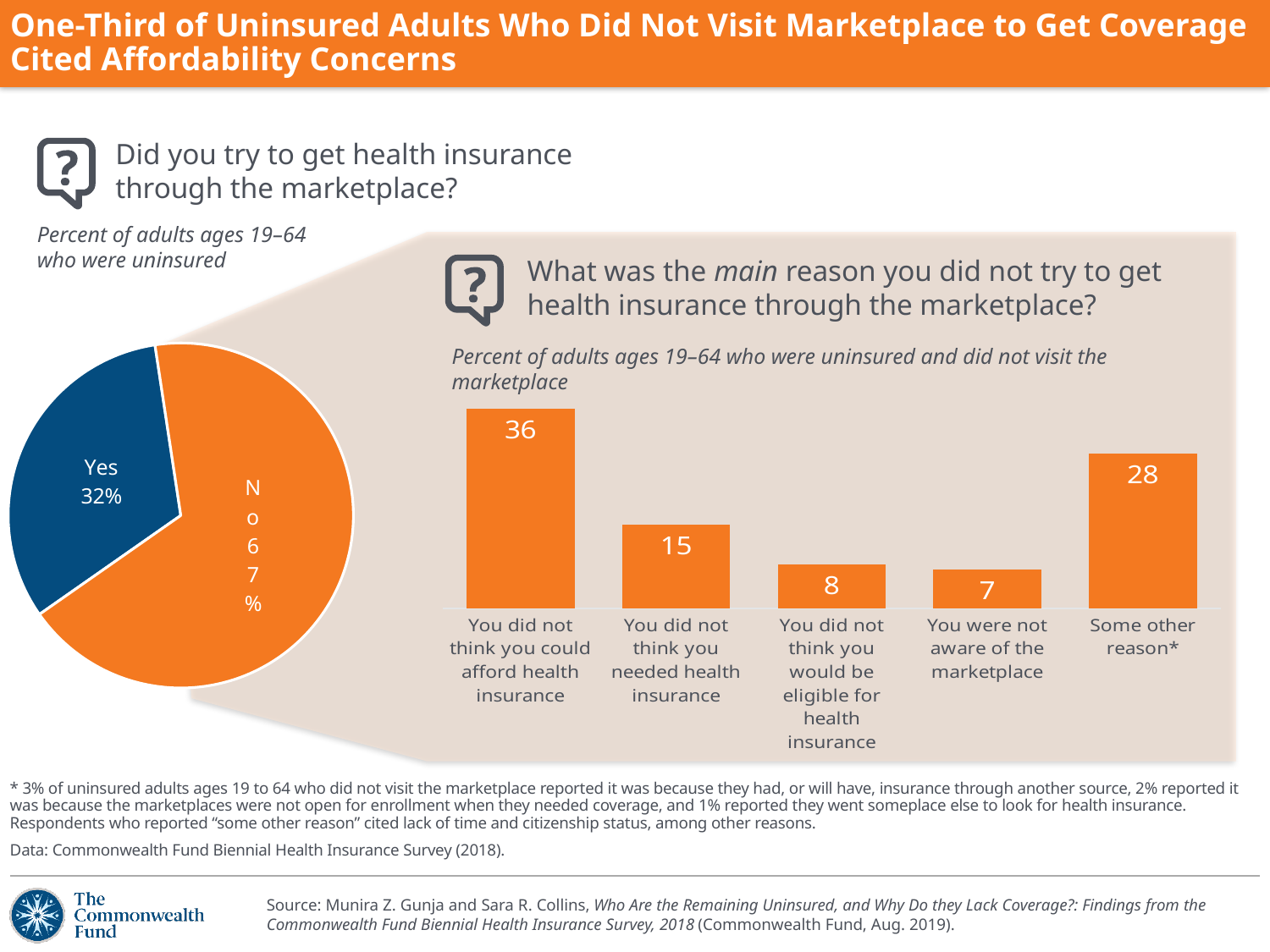
What type of chart is shown on the left side of the slide? Pie chart In the pie chart on the left, what percentage of uninsured adults said No? 67% In the bar chart on the right, which reason has the highest value? You did not think you could afford health insurance In the bar chart on the right, which reason has the lowest value? You were not aware of the marketplace In the pie chart on the left, what percentage of uninsured adults said Yes, they tried to get health insurance through the marketplace? 32% In the bar chart on the right, what is the difference between the value for not thinking they could afford health insurance and the value for not thinking they needed health insurance? 21 In the pie chart on the left, which slice is larger, Yes or No? No In the bar chart on the right, what percentage said they did not think they could afford health insurance? 36 What type of chart is shown on the right side of the slide? Bar chart In the bar chart on the right, what percentage cited some other reason? 28 How many reasons (bars) are shown in the bar chart on the right? 5 In the bar chart on the right, what percentage said they were not aware of the marketplace? 7